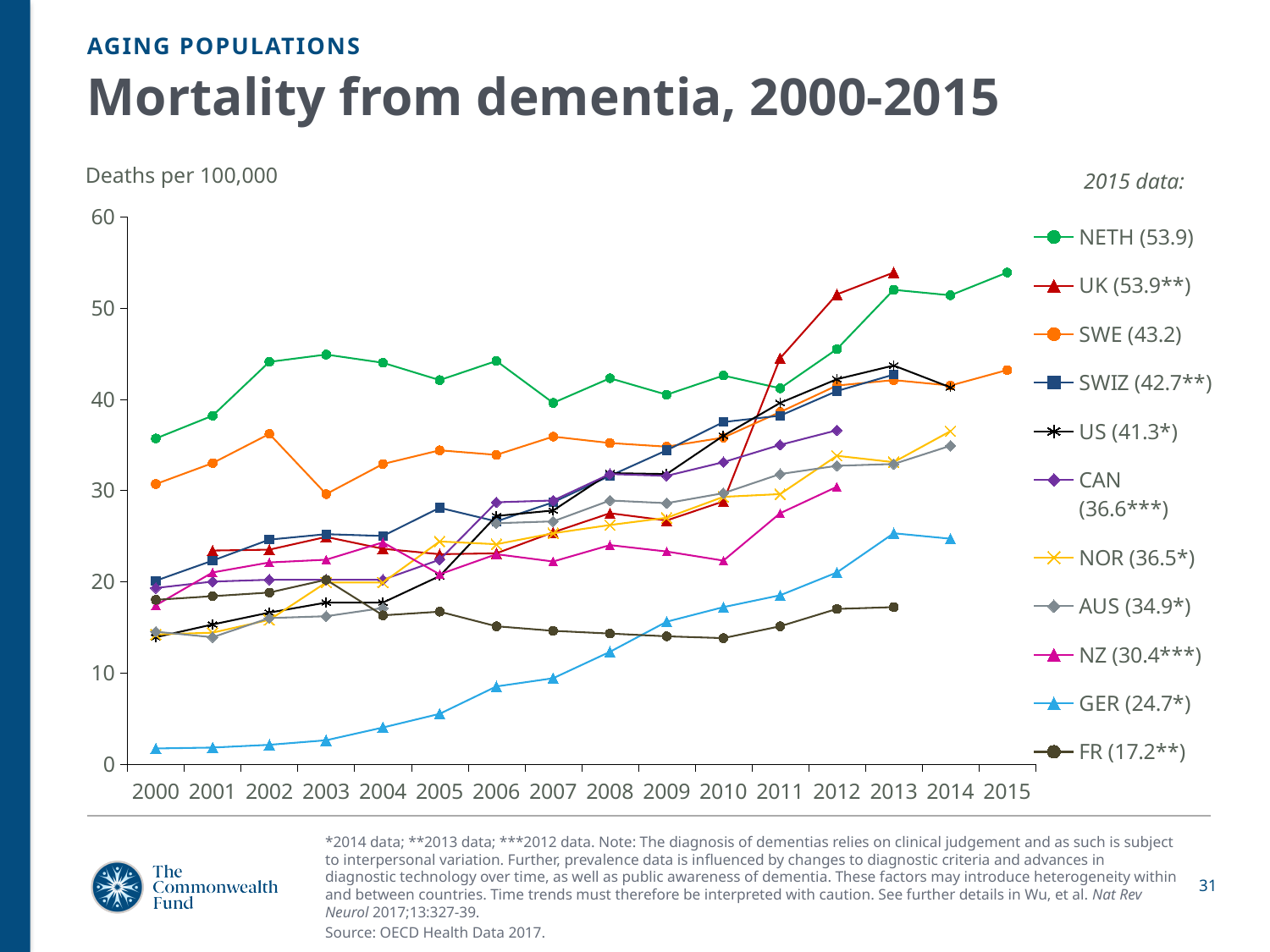
Which has the larger latest value in the legend, AUS or NZ? AUS What is the difference between the latest values for NETH and SWE shown in the legend? 10.7 Is the value for GER in 2000 greater or less than 10? less Which country has the lowest latest value in the legend? FR Is the value for NETH in 2000 greater or less than 30? greater What is the 2015 value for NETH shown in the legend? 53.9 What is the latest value for GER shown in the legend? 24.7 What is the unit label shown above the y axis? Deaths per 100,000 Do the values for GER rise or fall from 2000 to 2014? rise How many series does the legend list? 11 What kind of chart is shown on the slide? line chart What is the latest value for SWE shown in the legend? 43.2